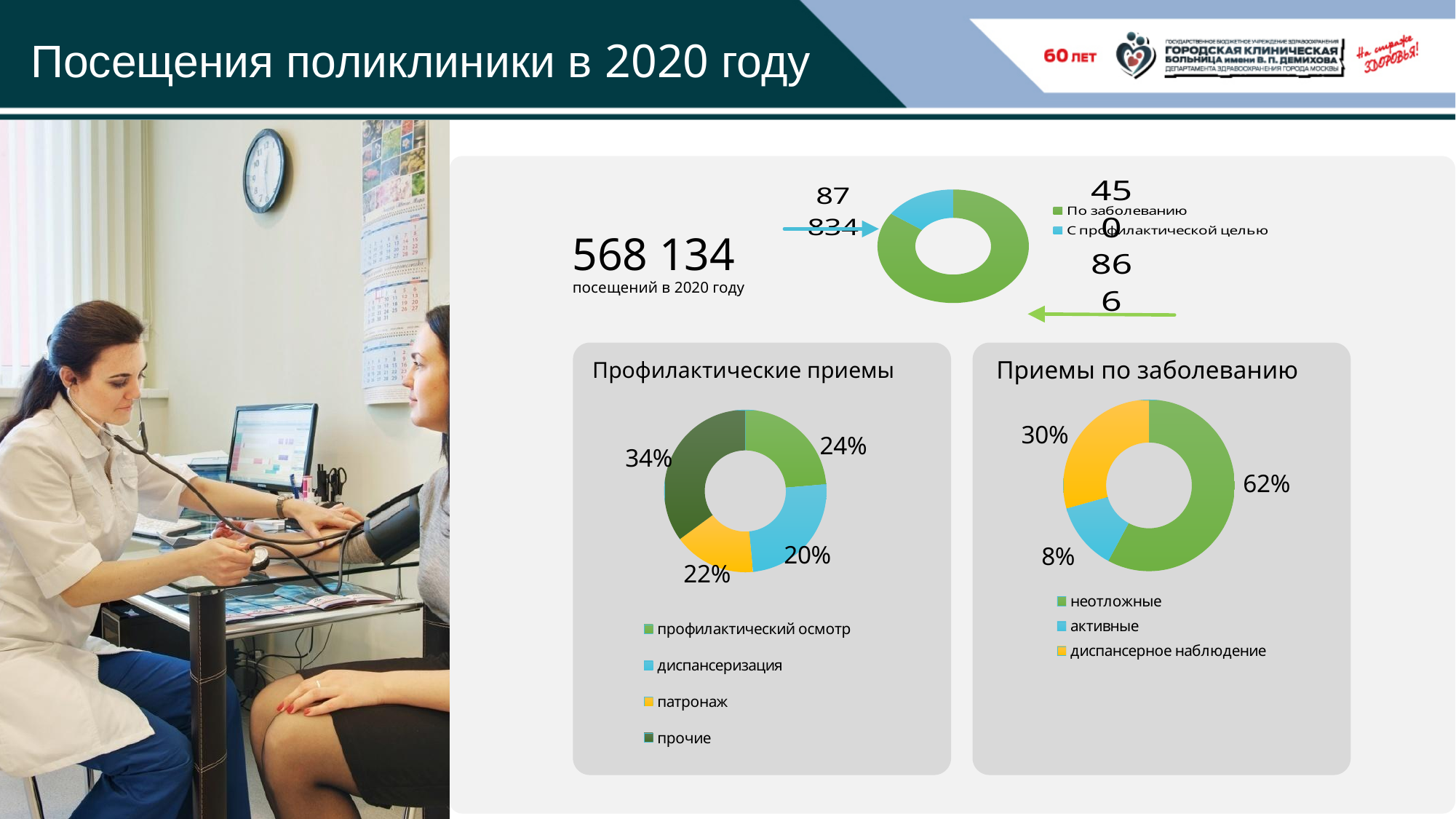
In the 'Приемы по заболеванию' chart, which is larger: 'активные' or 'диспансерное наблюдение'? диспансерное наблюдение In the top chart, which legend entry is shown in green? По заболеванию In the 'Профилактические приемы' chart, what share is 'патронаж'? 22% In the 'Профилактические приемы' chart, how many categories does the legend list? 4 What type of chart is used for 'Приемы по заболеванию'? Donut (pie) chart In the 'Приемы по заболеванию' chart, what share is 'неотложные'? 62% In the 'Приемы по заболеванию' chart, what is the difference in percentage points between 'неотложные' and 'диспансерное наблюдение'? 32 In the 'Профилактические приемы' chart, what share is 'диспансеризация'? 20% In the 'Профилактические приемы' chart, what share is 'прочие'? 34% In the 'Приемы по заболеванию' chart, what share is 'активные'? 8% In the 'Профилактические приемы' chart, which category has the largest share? прочие